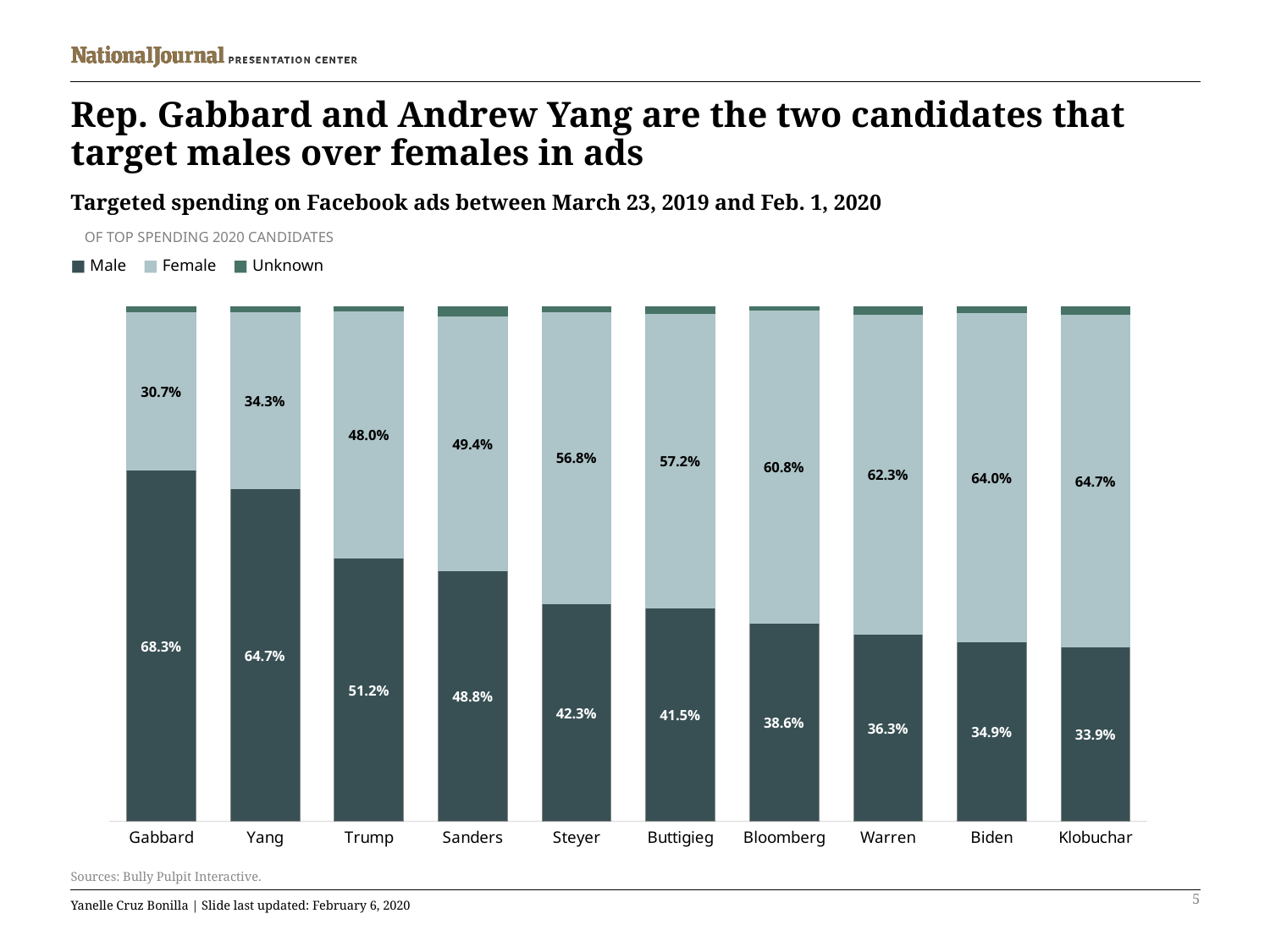
What share of Gabbard's targeted Facebook ad spending went to males? 68.3% What kind of chart is shown on the slide? stacked bar chart Moving from Gabbard to Klobuchar along the x axis, do the Male shares rise or fall? fall Is Trump's Male share larger or smaller than his Female share? larger Which candidate has the lowest Female share? Gabbard What is the Female value for Klobuchar? 64.7% How many candidates are shown on the x axis? 10 What is the difference between Yang's Male share and his Female share? 30.4% How many series does the legend list? 3 What is the Male value for Bloomberg? 38.6% Which candidate has the highest Male share? Gabbard What are the three series listed in the legend? Male, Female, Unknown